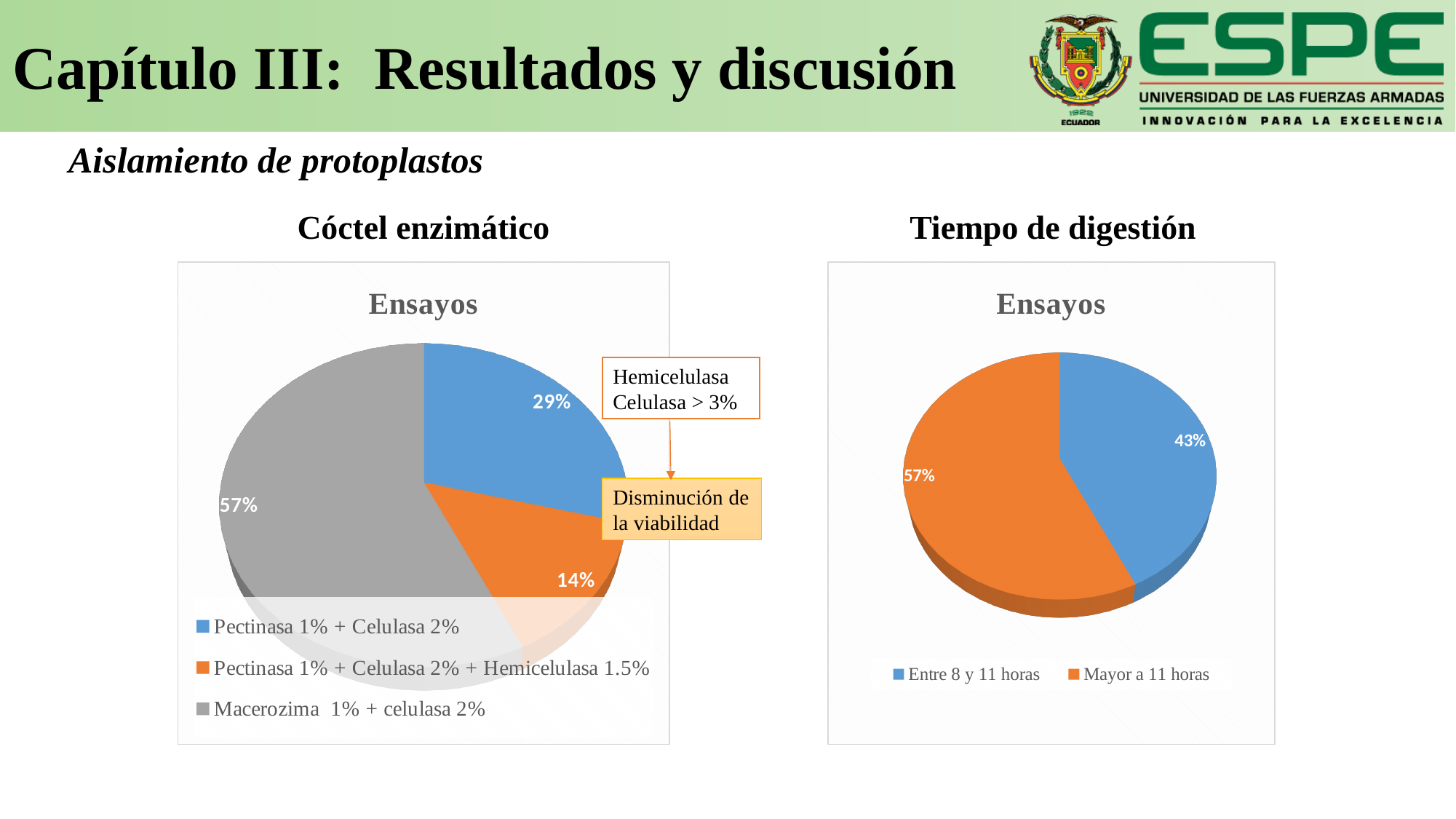
In the left chart (Cóctel enzimático), what percentage is shown for Pectinasa 1% + Celulasa 2%? 29% In the left chart (Cóctel enzimático), which category has the largest slice? Macerozima 1% + celulasa 2% What kind of chart is the right chart (Tiempo de digestión)? Pie chart How many categories does the left chart (Cóctel enzimático) show? 3 In the left chart (Cóctel enzimático), what share of the pie is Macerozima 1% + celulasa 2%? 57% In the left chart (Cóctel enzimático), what is the difference in percentage points between Macerozima 1% + celulasa 2% and Pectinasa 1% + Celulasa 2%? 28 In the left chart (Cóctel enzimático), what percentage is shown for Pectinasa 1% + Celulasa 2% + Hemicelulasa 1.5%? 14% What is the title shown inside both pie charts? Ensayos In the right chart (Tiempo de digestión), what percentage is shown for Entre 8 y 11 horas? 43% In the right chart (Tiempo de digestión), what share of the pie is Mayor a 11 horas? 57% In the left chart (Cóctel enzimático), which category has the smallest slice? Pectinasa 1% + Celulasa 2% + Hemicelulasa 1.5% In the right chart (Tiempo de digestión), which is larger: Entre 8 y 11 horas or Mayor a 11 horas? Mayor a 11 horas